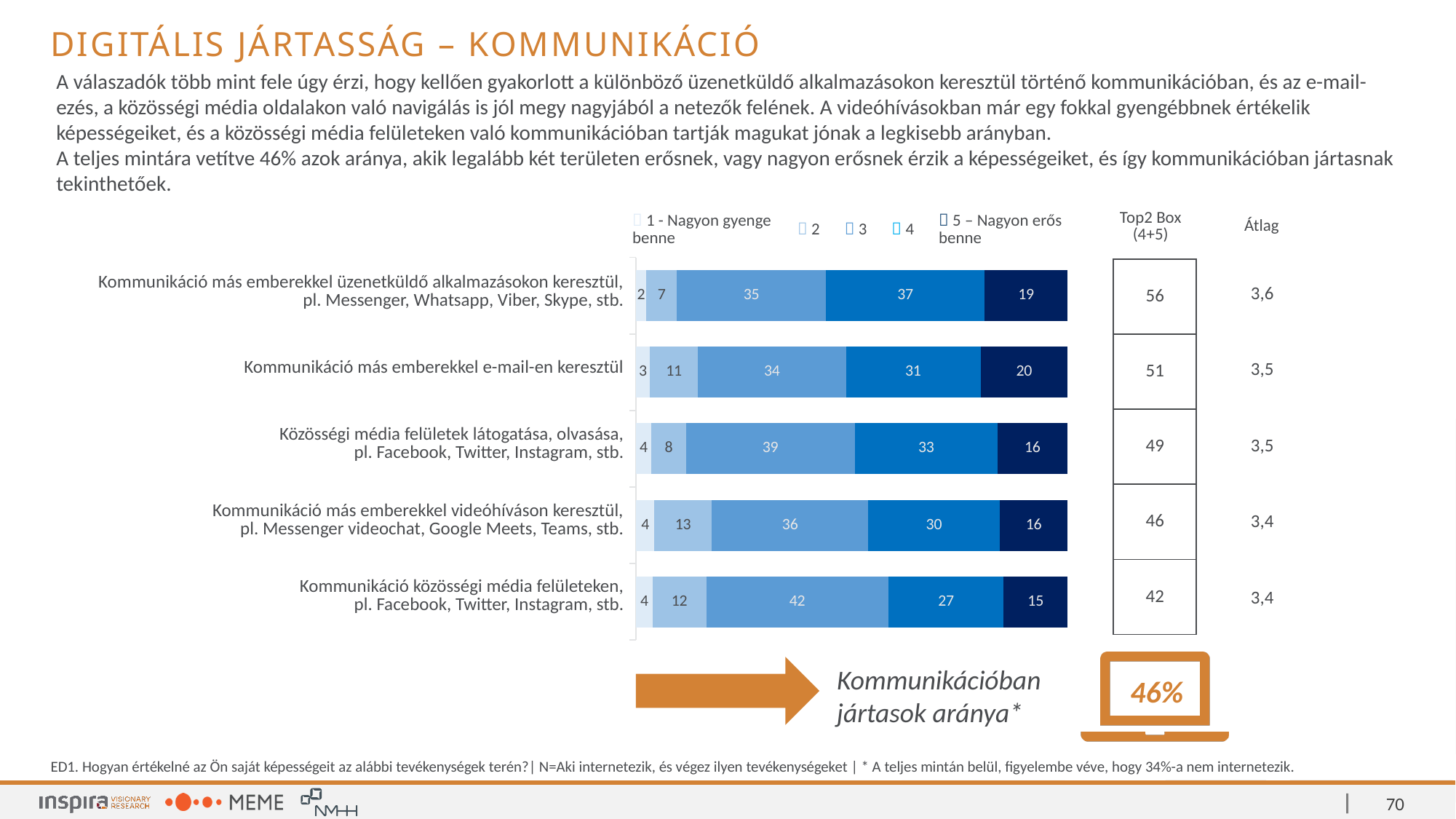
What is the difference between the "4" segment values for the messaging apps category (üzenetküldő alkalmazásokon) and the social media communication category (közösségi média felületeken)? 10 Which category has the lowest value for the "4" segment? Kommunikáció közösségi média felületeken, pl. Facebook, Twitter, Instagram, stb. How many series does the chart legend list? 5 What is the Top2 Box (4+5) value shown for "Kommunikáció más emberekkel videóhíváson keresztül"? 46 Which has a larger "3" segment value: "Kommunikáció más emberekkel videóhíváson keresztül" or "Kommunikáció más emberekkel e-mail-en keresztül"? Kommunikáció más emberekkel videóhíváson keresztül How many categories (activities) are plotted in the chart? 5 What kind of chart is shown on the slide? stacked bar chart Which category has the highest value for the "4" segment? Kommunikáció más emberekkel üzenetküldő alkalmazásokon keresztül, pl. Messenger, Whatsapp, Viber, Skype, stb. What is the total of the stacked bar for "Kommunikáció más emberekkel üzenetküldő alkalmazásokon keresztül"? 100 What is the value of the "3" segment for "Kommunikáció közösségi média felületeken, pl. Facebook, Twitter, Instagram, stb."? 42 What is the first entry in the chart legend? 1 - Nagyon gyenge benne What is the value of the "5 – Nagyon erős benne" segment for "Kommunikáció más emberekkel e-mail-en keresztül"? 20